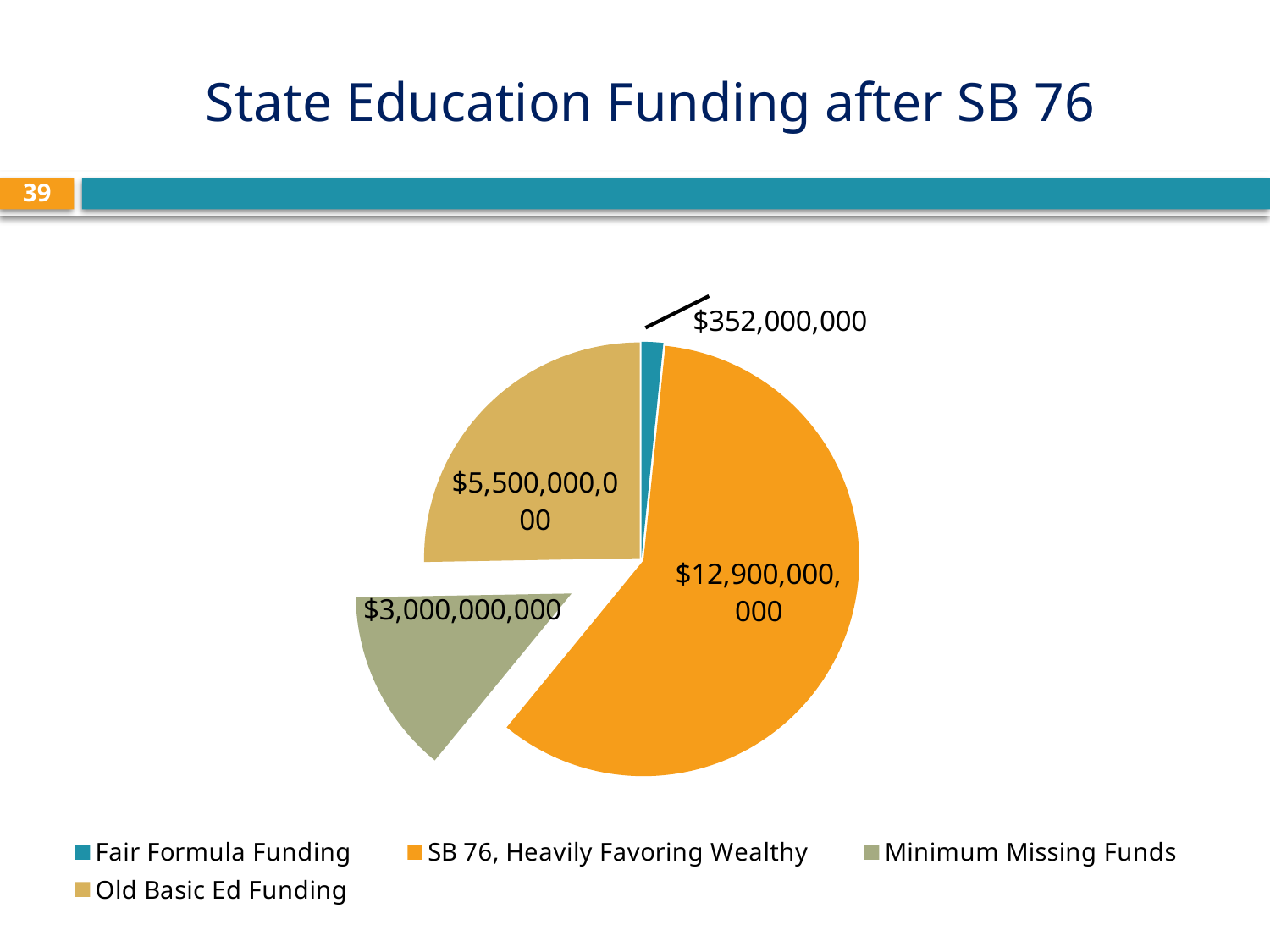
What is the difference between Old Basic Ed Funding and Minimum Missing Funds? $2,500,000,000 What is the value for Minimum Missing Funds? $3,000,000,000 How many categories does the legend list? 4 What is the value for Old Basic Ed Funding? $5,500,000,000 What is the value for SB 76, Heavily Favoring Wealthy? $12,900,000,000 Which category has the smallest slice of the pie? Fair Formula Funding What kind of chart is shown on the slide? Pie chart What is the value for Fair Formula Funding? $352,000,000 Which is larger, Old Basic Ed Funding or Minimum Missing Funds? Old Basic Ed Funding What is the difference between SB 76, Heavily Favoring Wealthy and Old Basic Ed Funding? $7,400,000,000 Which category has the largest slice of the pie? SB 76, Heavily Favoring Wealthy What is the title of the slide containing the pie chart? State Education Funding after SB 76